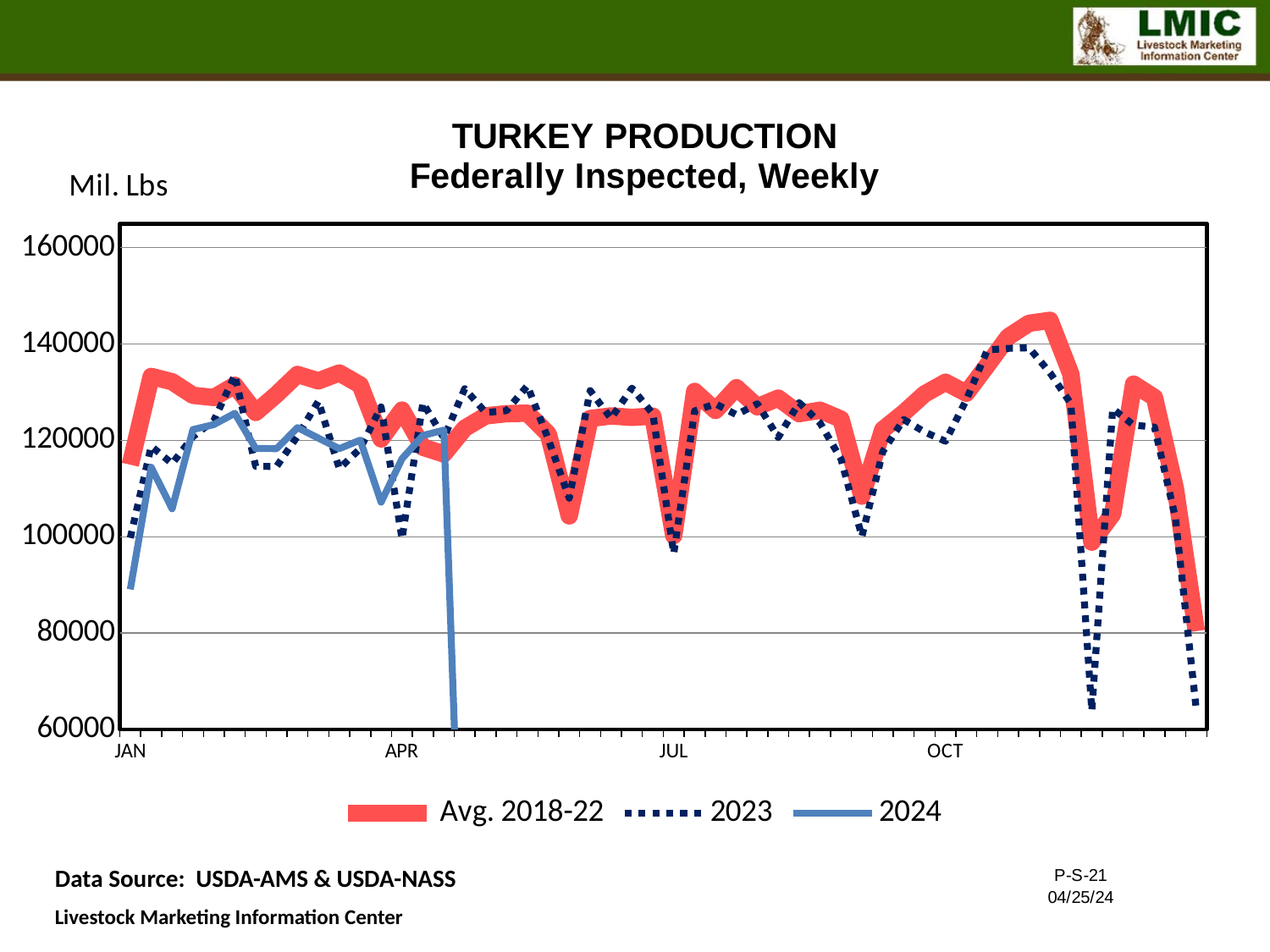
What kind of chart is shown on the slide? Line chart Is the peak value of the Avg. 2018-22 line in November greater or less than 140000? greater How many month labels are shown on the x axis? 4 Is the lowest value of the 2023 line in late November greater or less than 80000? less Is the value of the 2024 line at the start of January greater or less than 100000? less What is the title of the chart? TURKEY PRODUCTION Federally Inspected, Weekly How many series does the legend list? 3 In January, which line is higher: Avg. 2018-22 or 2024? Avg. 2018-22 From its November peak to the end of December, does the Avg. 2018-22 line rise or fall? fall Which series reaches the highest value on the chart? Avg. 2018-22 What unit is shown on the y axis of the chart? Mil. Lbs